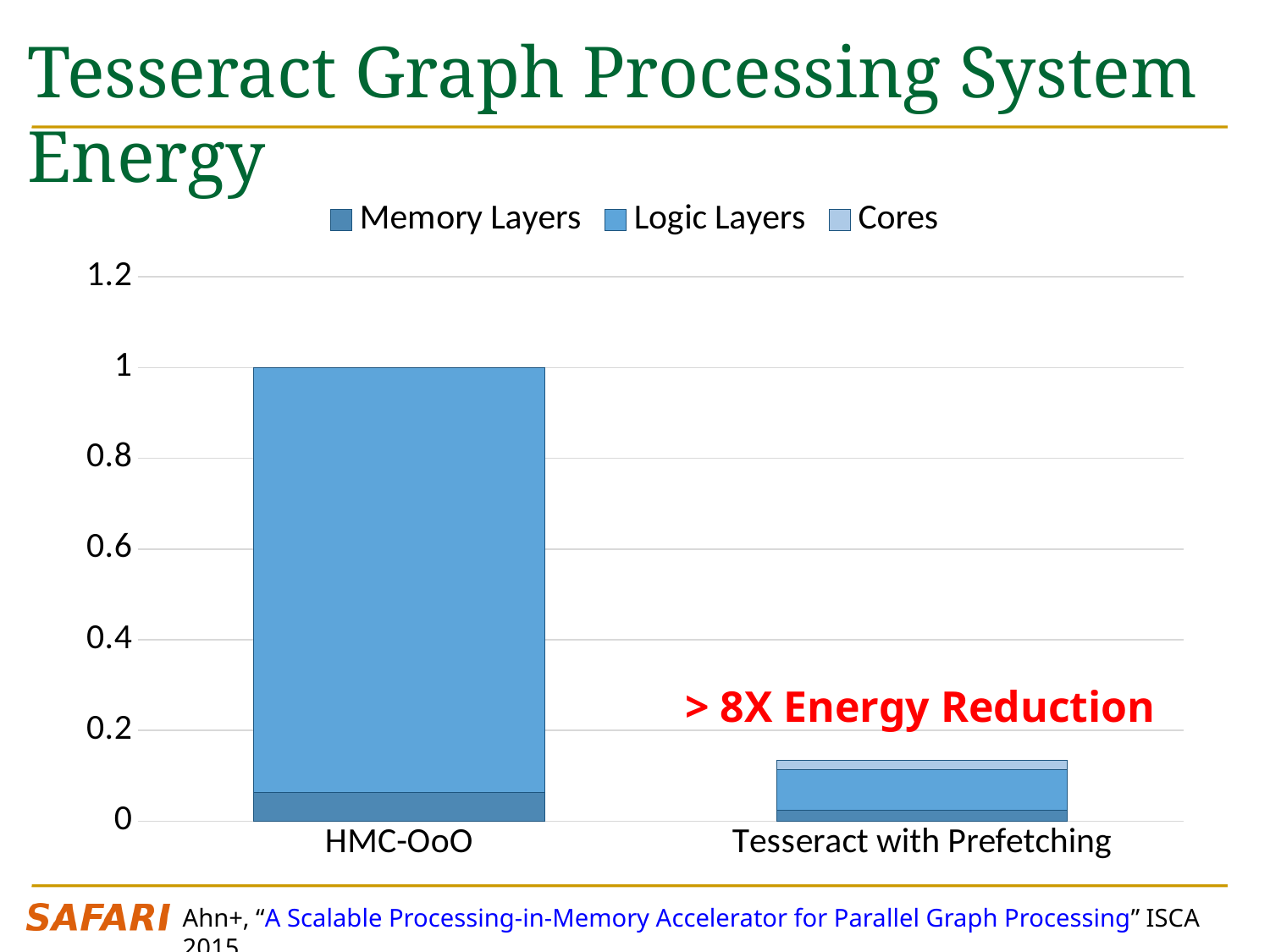
How many series does the legend list? 3 What does the red annotation on the chart say? > 8X Energy Reduction What are the three series listed in the legend? Memory Layers, Logic Layers, Cores Is the total value for Tesseract with Prefetching greater or less than 0.2? less Which category has the lowest total energy? Tesseract with Prefetching Do the total bar values rise or fall from left to right along the x axis? fall What is the total height of the stacked bar for HMC-OoO? 1 Which has a larger total bar, HMC-OoO or Tesseract with Prefetching? HMC-OoO Is the Memory Layers value for HMC-OoO greater or less than 0.2? less What kind of chart is shown on the slide? bar chart How many categories are shown on the x axis? 2 Which category has the highest total energy? HMC-OoO